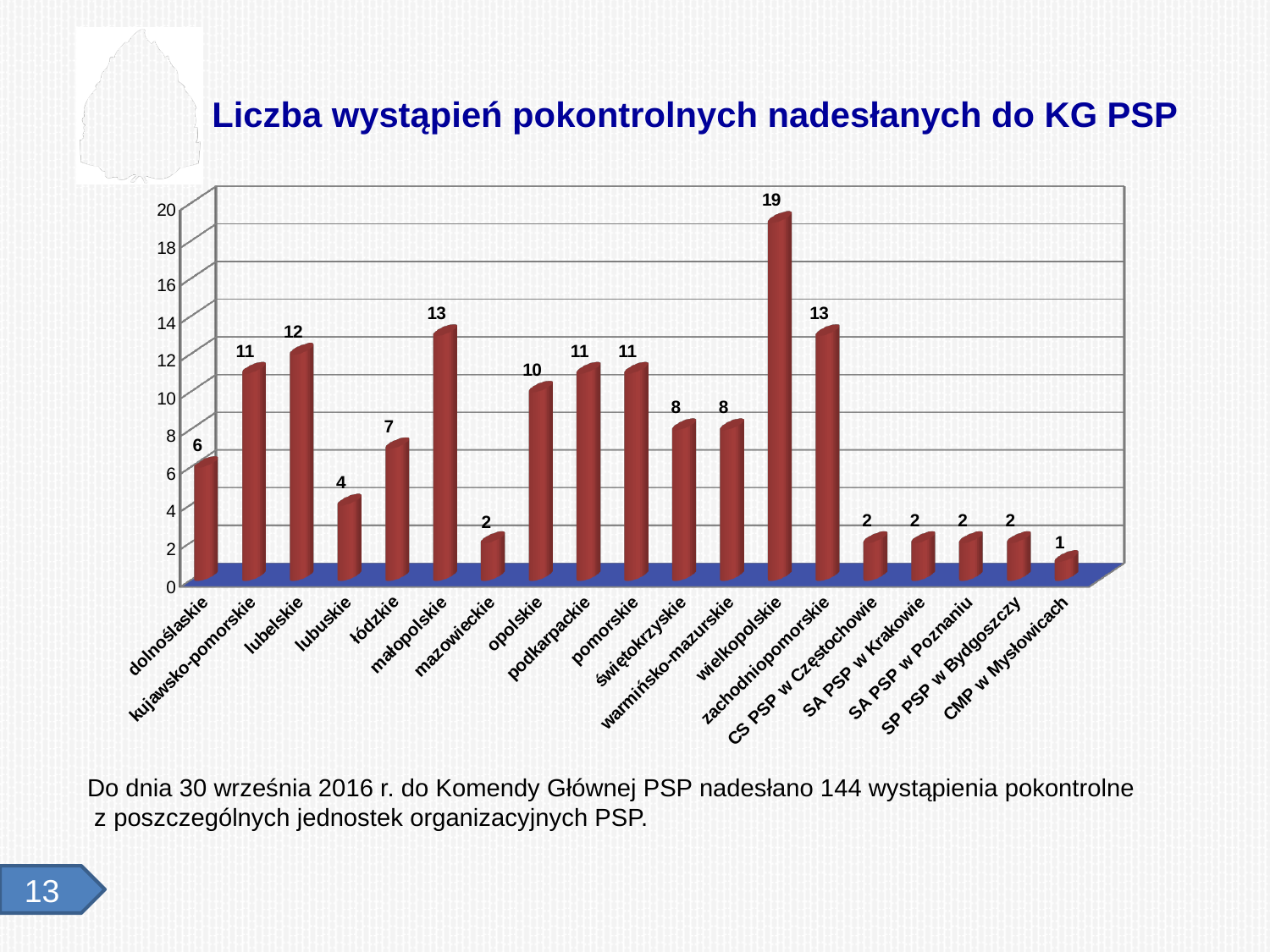
Which category has the highest value? wielkopolskie What is the value for CMP w Mysłowicach? 1 What is the title of the chart? Liczba wystąpień pokontrolnych nadesłanych do KG PSP Which category has the lowest value? CMP w Mysłowicach Which is larger, the value for opolskie or the value for łódzkie? opolskie What kind of chart is shown on the slide? bar chart What is the value for zachodniopomorskie? 13 What is the value for wielkopolskie? 19 What is the value for lubuskie? 4 What is the difference between the values for wielkopolskie and małopolskie? 6 What is the difference between the values for lubelskie and dolnośląskie? 6 How many categories are shown on the x axis? 19